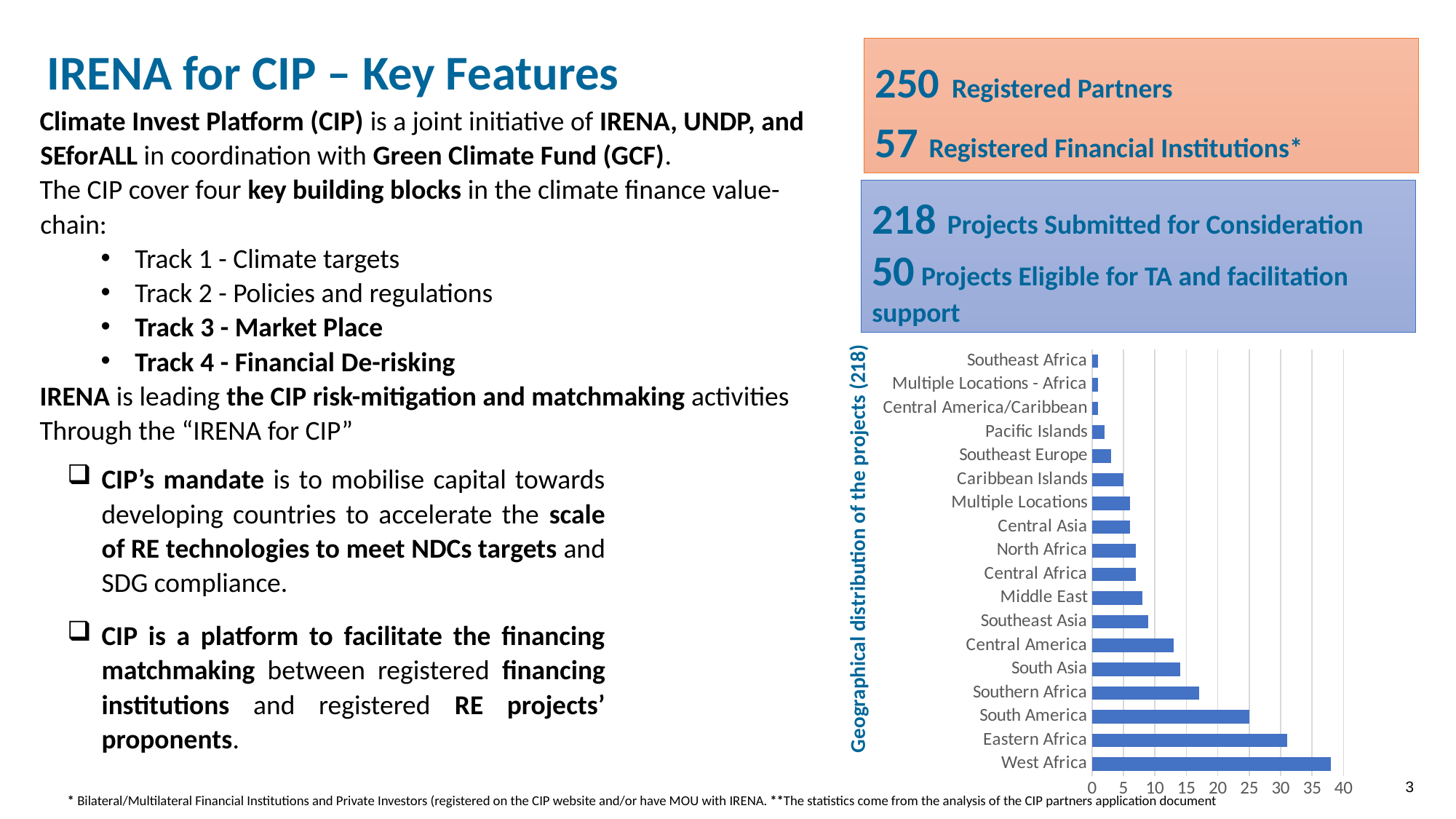
What is the title shown along the vertical axis of the bar chart? Geographical distribution of the projects (218) Is the value for Pacific Islands greater or less than 5? less How many regions are listed in the bar chart? 18 Is the value for West Africa greater or less than 35? greater What kind of chart is shown on the slide? bar chart Which has more projects, Caribbean Islands or Pacific Islands? Caribbean Islands Is the value for Central America greater or less than 10? greater Which has more projects, South America or Southern Africa? South America Which has more projects, West Africa or Eastern Africa? West Africa Which region has the highest number of projects in the bar chart? West Africa